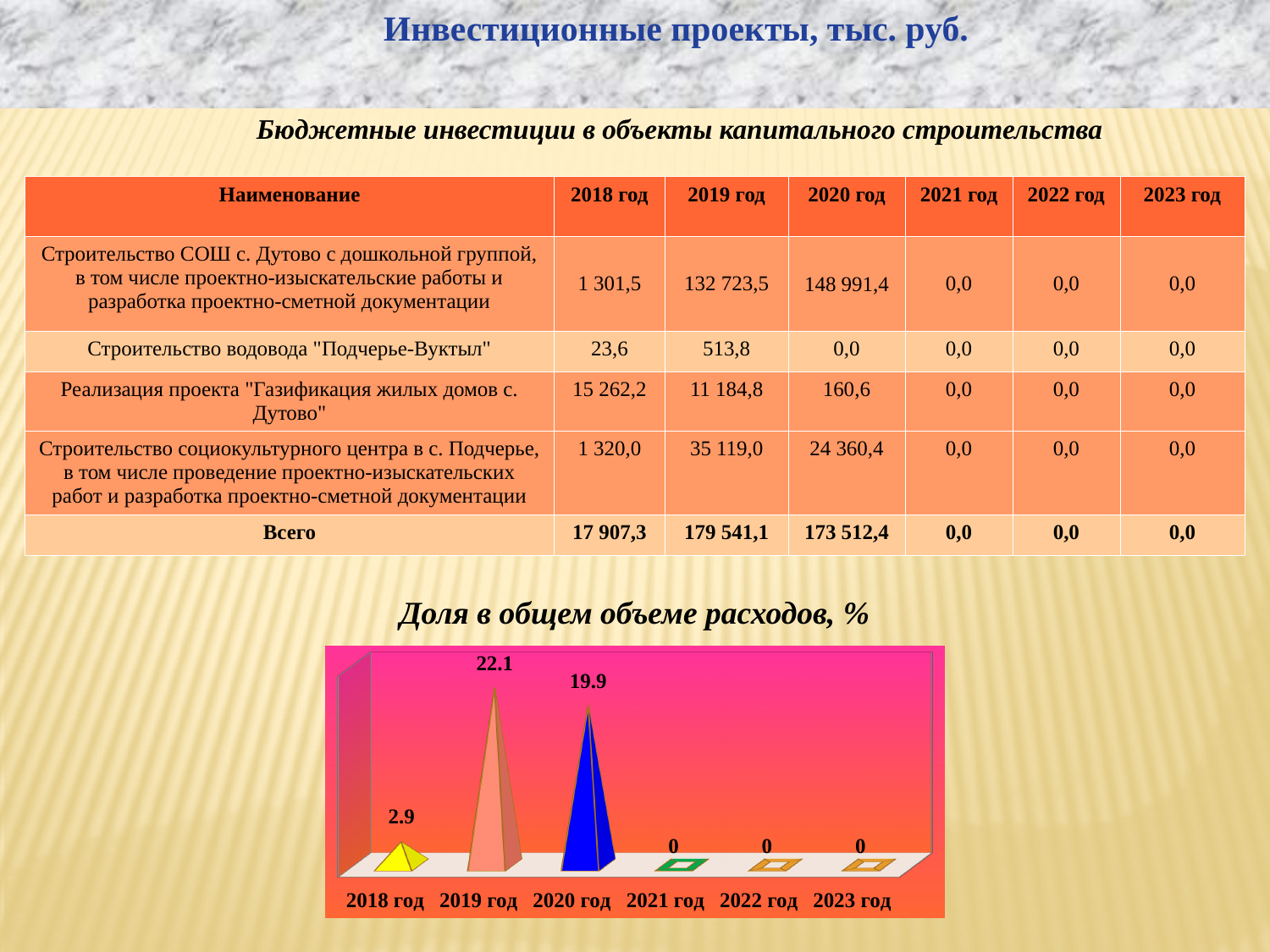
What is the title of the chart at the bottom of the slide? Доля в общем объеме расходов, % What is the value for 2018 год in the chart 'Доля в общем объеме расходов, %'? 2.9 Which year has the highest value in the chart 'Доля в общем объеме расходов, %'? 2019 год What is the value for 2020 год in the chart 'Доля в общем объеме расходов, %'? 19.9 What is the difference between the values for 2019 год and 2020 год in the chart 'Доля в общем объеме расходов, %'? 2.2 How many year categories are shown on the x axis of the chart 'Доля в общем объеме расходов, %'? 6 What kind of chart is 'Доля в общем объеме расходов, %'? Bar chart What is the difference between the values for 2019 год and 2018 год in the chart 'Доля в общем объеме расходов, %'? 19.2 In the chart 'Доля в общем объеме расходов, %', which is larger: the value for 2018 год or the value for 2020 год? 2020 год What is the value for 2019 год in the chart 'Доля в общем объеме расходов, %'? 22.1 How many years in the chart 'Доля в общем объеме расходов, %' have a value of 0? 3 What is the value for 2021 год in the chart 'Доля в общем объеме расходов, %'? 0